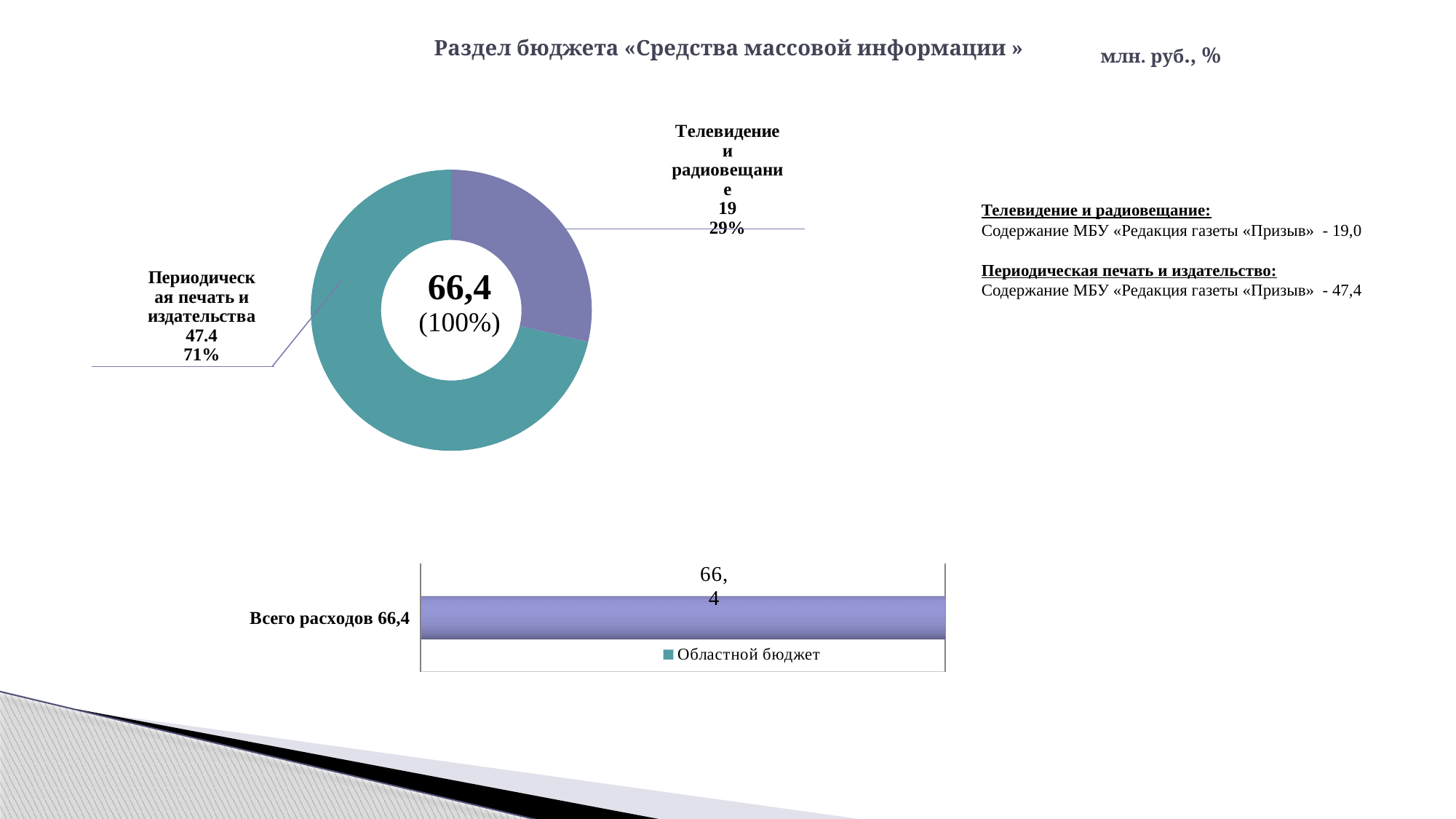
In the donut chart, what share does Телевидение и радиовещание have? 29% In the donut chart, how many slices are there? 2 In the donut chart, which category has the smallest slice? Телевидение и радиовещание In the lower bar chart, what series does the legend list? Областной бюджет In the donut chart, what share does Периодическая печать и издательства have? 71% In the donut chart, which category has the largest slice? Периодическая печать и издательства In the donut chart, what is the value for Телевидение и радиовещание? 19 In the donut chart, what total value is shown in the centre? 66,4 What kind of chart is the lower chart on the slide? bar chart In the lower bar chart, what is the value of the bar for Всего расходов? 66,4 In the donut chart, which is larger: Телевидение и радиовещание or Периодическая печать и издательства? Периодическая печать и издательства In the donut chart, what is the value for Периодическая печать и издательства? 47.4